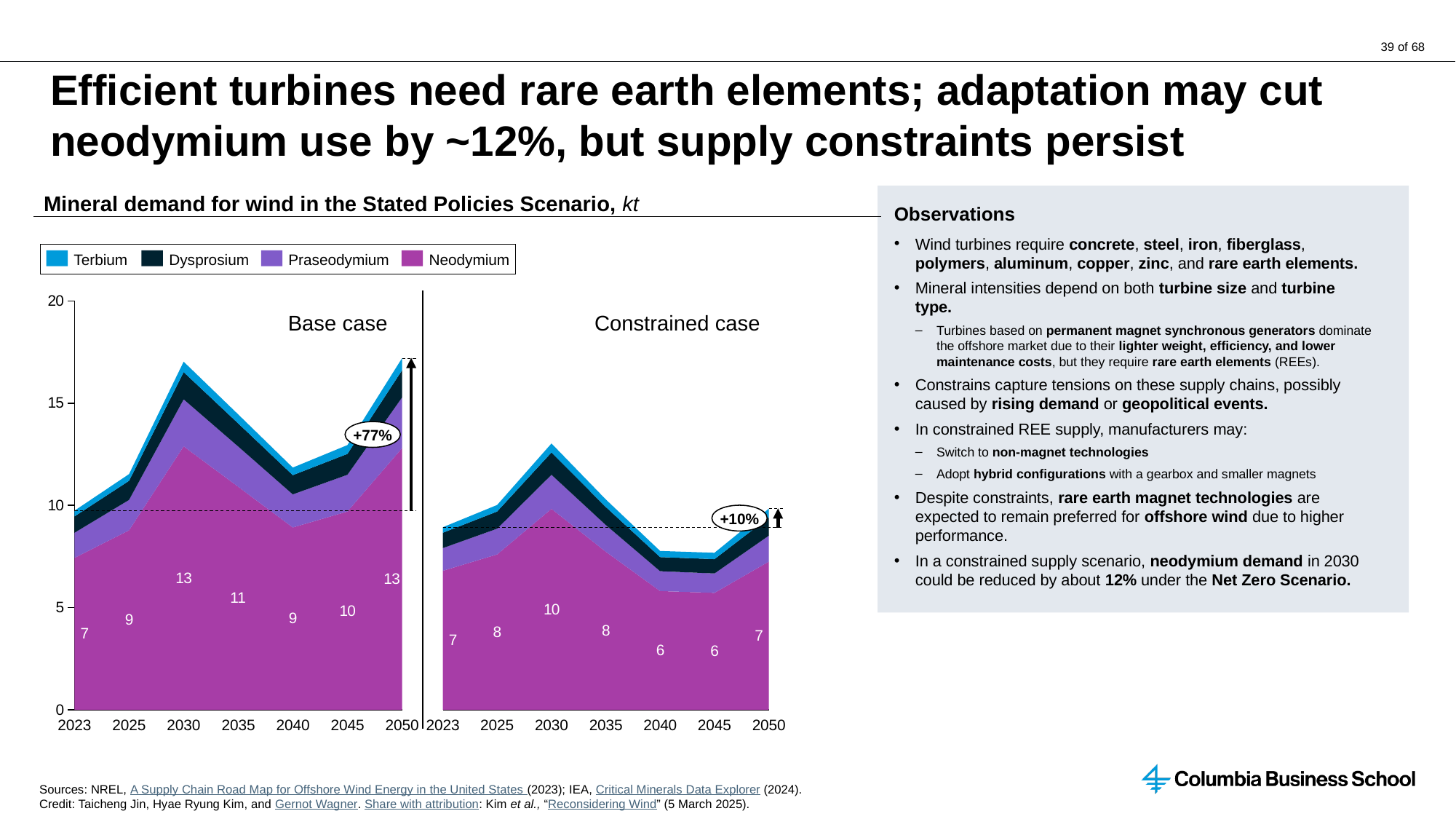
In the Base case panel, is the total mineral demand in 2030 greater or less than 15? greater How many series does the legend list? 4 In the Constrained case panel, what is the neodymium demand in 2040? 6 In the Base case panel, which year has the lowest neodymium demand? 2023 What unit is given in the chart title for mineral demand? kt What percentage increase is annotated for the Base case between 2023 and 2050? +77% What kind of chart is shown on the slide? Stacked area chart Which is larger in 2035: neodymium demand in the Base case or in the Constrained case? Base case In the Base case panel, what is the neodymium demand in 2030? 13 In the Constrained case panel, which year has the highest neodymium demand? 2030 How many years are shown on the x axis of the Base case panel? 7 In the Base case panel, what is the difference between neodymium demand in 2030 and in 2023? 6